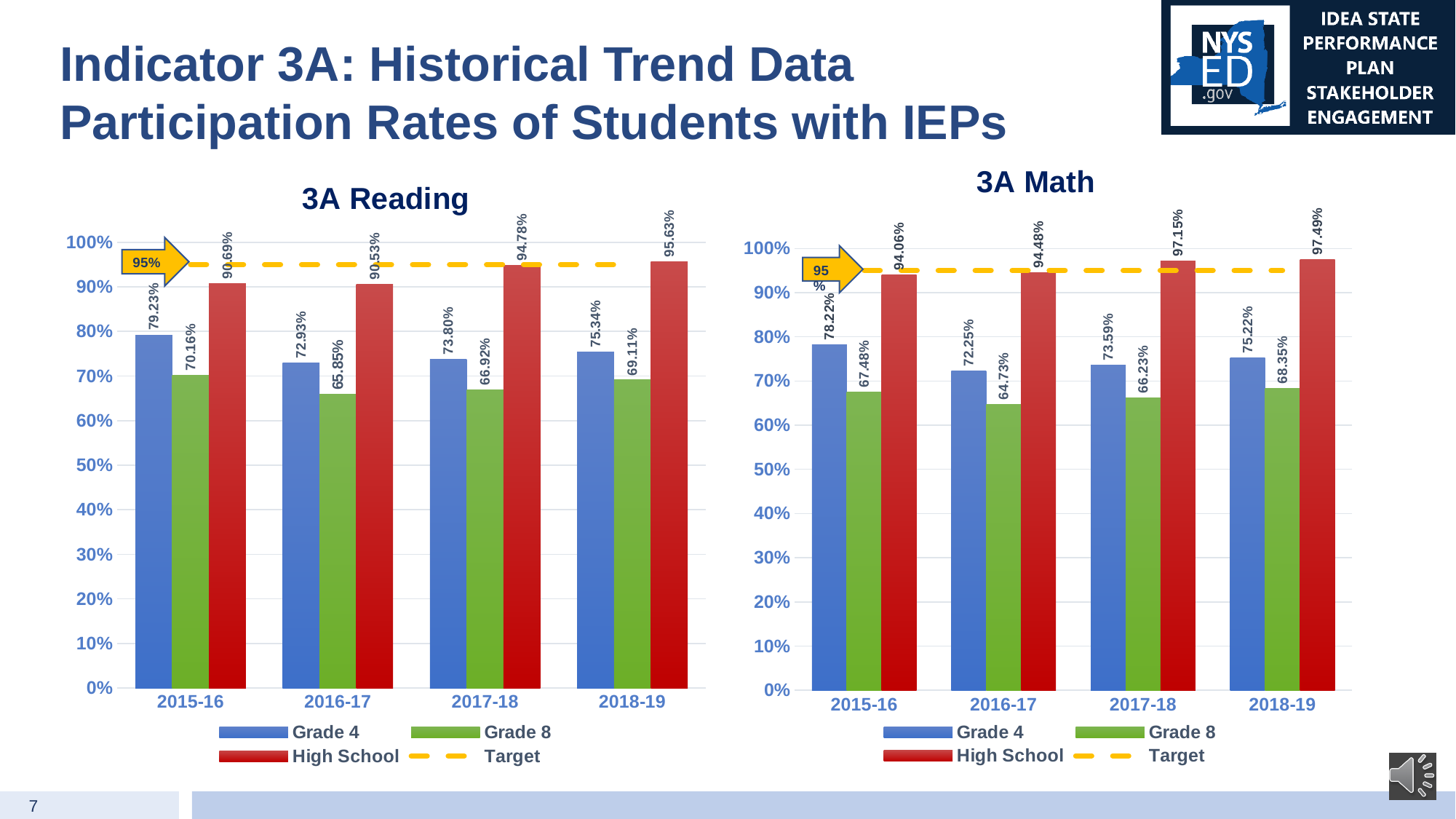
In the 3A Reading chart, what is the Grade 4 participation rate for 2015-16? 79.23% In the 3A Reading chart, which year has the highest High School participation rate? 2018-19 In the 3A Math chart, which year has the lowest Grade 8 participation rate? 2016-17 What target value is marked by the dashed line in the 3A Reading chart? 95% In the 3A Math chart, what is the difference between the High School and Grade 4 rates in 2015-16? 15.84% What kind of chart is the 3A Reading chart? bar chart In the 3A Math chart, is the High School value for 2016-17 greater or less than 90%? greater In the 3A Math chart, what is the High School participation rate for 2018-19? 97.49% How many entries does the legend of the 3A Math chart list? 4 In the 3A Reading chart, what is the Grade 8 value for 2017-18? 66.92% In the 3A Reading chart, is the Grade 4 rate for 2018-19 higher or lower than the Grade 8 rate for 2018-19? higher How many school years are shown on the x axis of the 3A Reading chart? 4